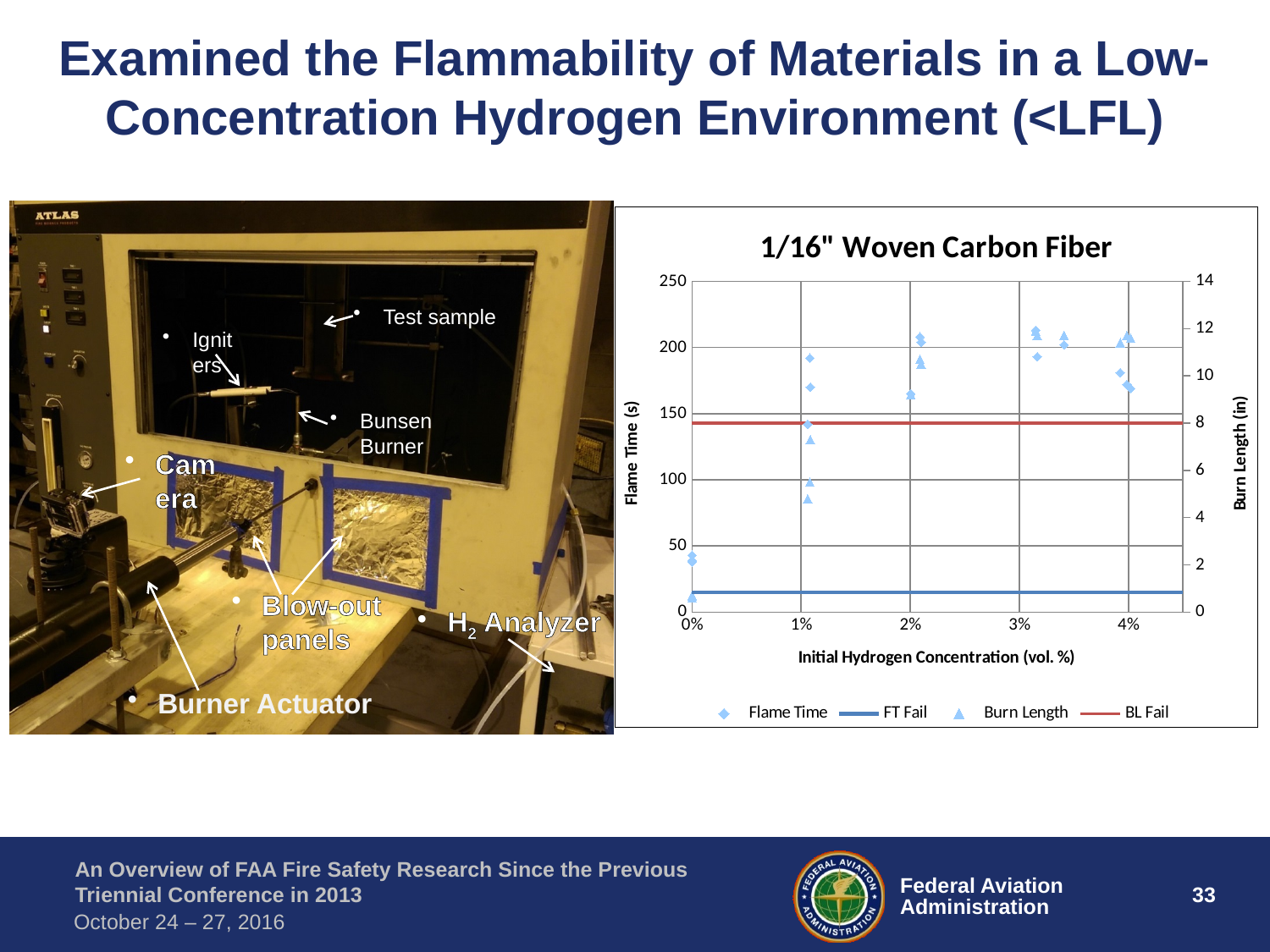
How many tick labels are shown on the x axis (Initial Hydrogen Concentration)? 5 What is the title of the chart? 1/16" Woven Carbon Fiber What is the maximum value shown on the right vertical axis (Burn Length)? 14 Which series in the chart is drawn as a red line? BL Fail How many series does the chart legend list? 4 Is the FT Fail line on the chart above or below 50 on the Flame Time axis? below Is the highest Flame Time value at 1% hydrogen concentration greater or less than 150 s? greater Do the Flame Time values generally rise or fall as the initial hydrogen concentration increases from 0% to 4%? rise What is the maximum value shown on the left vertical axis (Flame Time)? 250 Are the Flame Time values at 0% hydrogen concentration greater or less than 50 s? less What kind of chart is shown on the slide? scatter chart